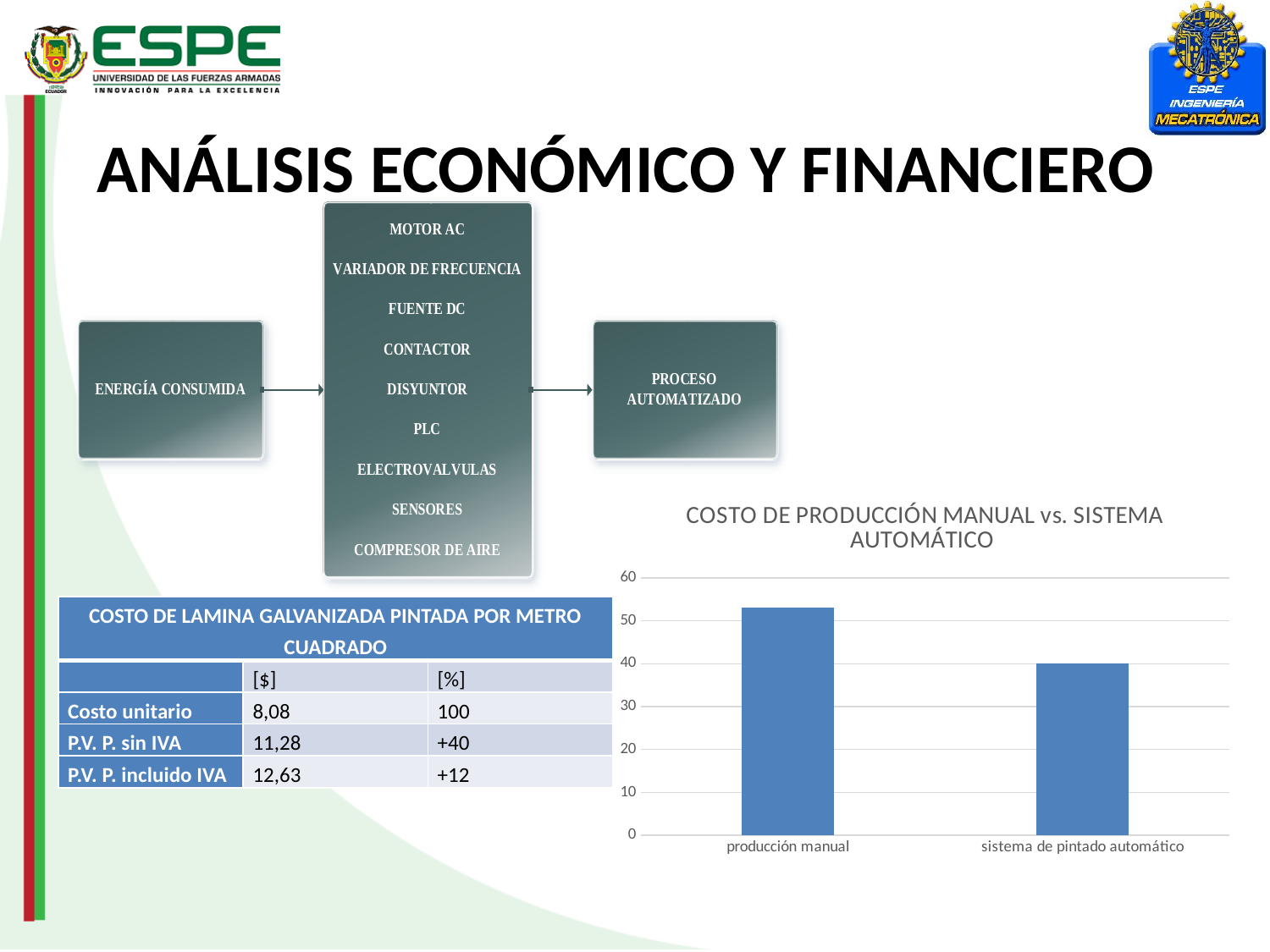
What is the title of the bar chart on the slide? COSTO DE PRODUCCIÓN MANUAL vs. SISTEMA AUTOMÁTICO How many categories are plotted in the 'COSTO DE PRODUCCIÓN MANUAL vs. SISTEMA AUTOMÁTICO' chart? 2 What is the highest value shown on the vertical axis of the 'COSTO DE PRODUCCIÓN MANUAL vs. SISTEMA AUTOMÁTICO' chart? 60 Which category has the highest bar in the 'COSTO DE PRODUCCIÓN MANUAL vs. SISTEMA AUTOMÁTICO' chart? producción manual In the 'COSTO DE PRODUCCIÓN MANUAL vs. SISTEMA AUTOMÁTICO' chart, is the value for producción manual greater or less than 60? less In the 'COSTO DE PRODUCCIÓN MANUAL vs. SISTEMA AUTOMÁTICO' chart, is the value for sistema de pintado automático greater or less than 50? less In the 'COSTO DE PRODUCCIÓN MANUAL vs. SISTEMA AUTOMÁTICO' chart, is the value for producción manual greater or less than 50? greater Do the bars in the 'COSTO DE PRODUCCIÓN MANUAL vs. SISTEMA AUTOMÁTICO' chart rise or fall from left to right? fall Which category has the lowest bar in the 'COSTO DE PRODUCCIÓN MANUAL vs. SISTEMA AUTOMÁTICO' chart? sistema de pintado automático What kind of chart is shown under the title 'COSTO DE PRODUCCIÓN MANUAL vs. SISTEMA AUTOMÁTICO'? bar chart In the 'COSTO DE PRODUCCIÓN MANUAL vs. SISTEMA AUTOMÁTICO' chart, which is larger: producción manual or sistema de pintado automático? producción manual